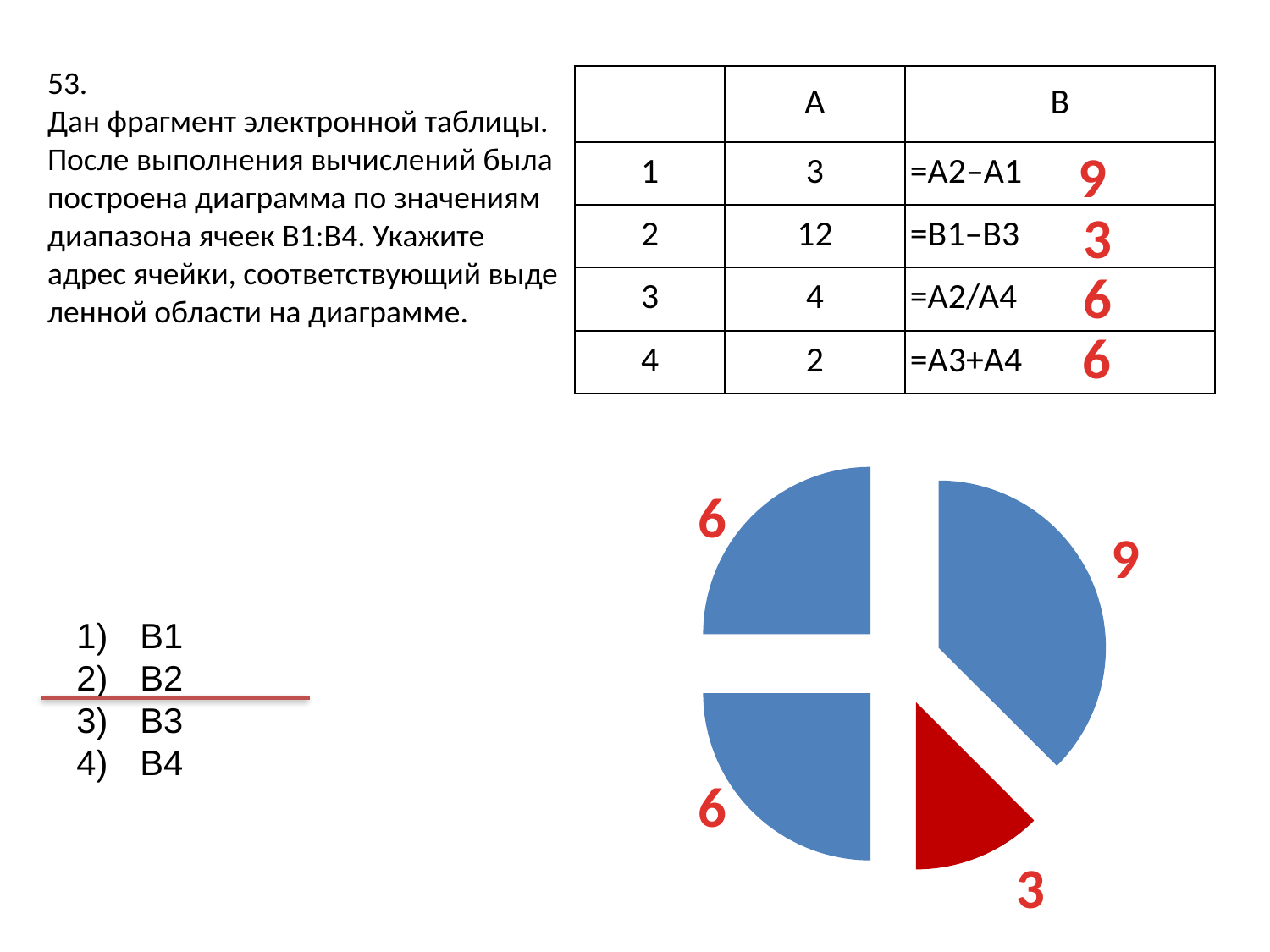
What value is labelled on the upper-right slice of the pie chart? 9 What colour is the highlighted slice of the pie chart? red Which is larger: the upper-right slice labelled 9 or the red slice labelled 3? the upper-right slice (9) What share of the pie does the red slice labelled 3 represent? 12.5% What is the largest value labelled on the pie chart? 9 What is the difference between the largest slice value (9) and the red slice value (3)? 6 How many slices does the pie chart have? 4 What is the total of all the slice values labelled on the pie chart? 24 What value is labelled on the upper-left slice of the pie chart? 6 What value is labelled on the red slice of the pie chart? 3 What is the smallest value labelled on the pie chart? 3 What kind of chart is shown on the slide? pie chart